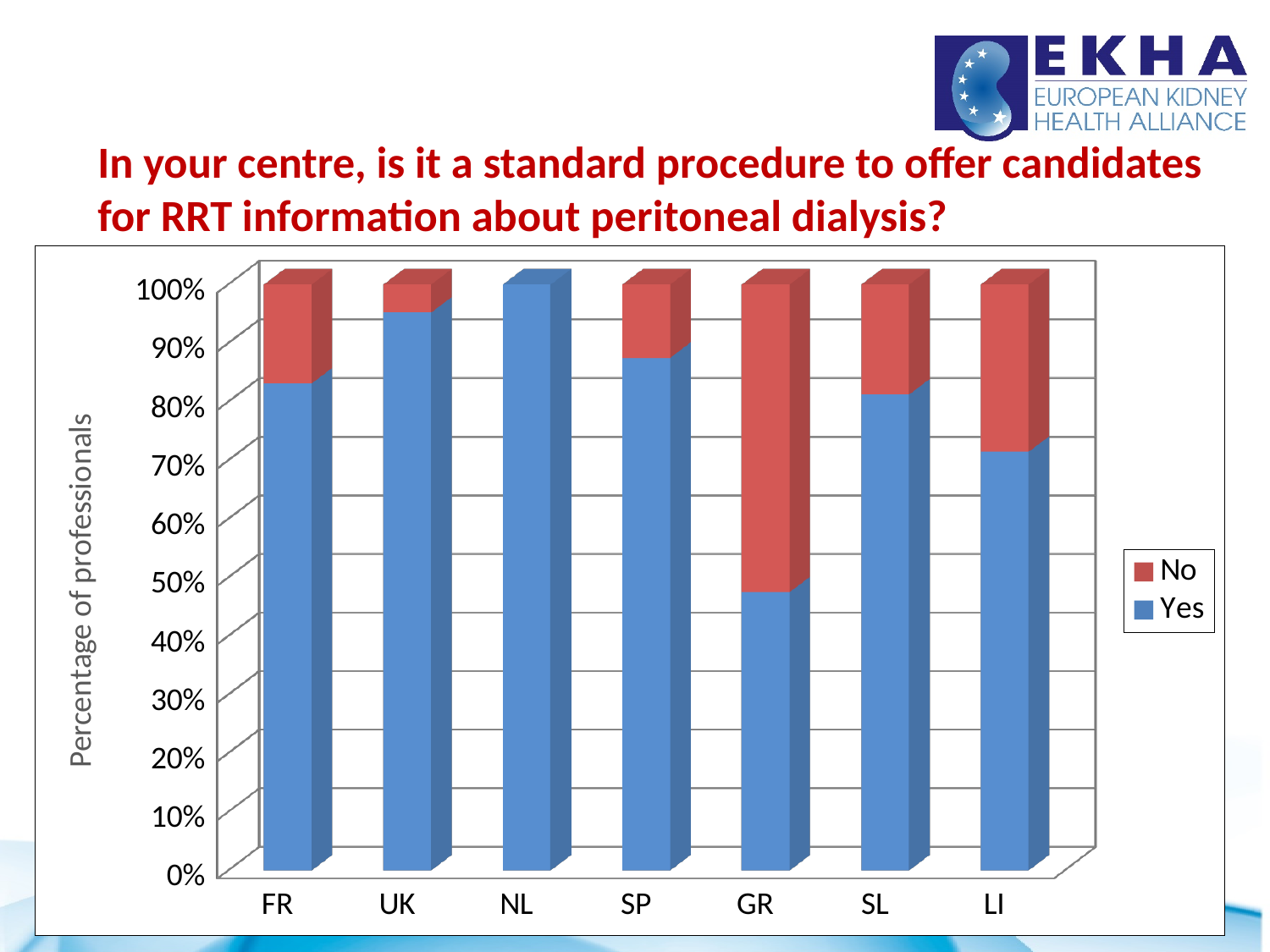
Is the Yes value for GR greater or less than 60%? less What is the label of the vertical axis? Percentage of professionals Is the Yes value for UK greater or less than 90%? greater Which has the larger Yes share, UK or FR? UK Which country has the lowest Yes share? GR What is the Yes value for NL? 100% Which country has the highest Yes share? NL Which country has the largest No share? GR How many countries are shown on the x axis of the chart? 7 How many series does the chart legend list? 2 Is the Yes value for LI greater or less than 80%? less What kind of chart is shown on the slide? Stacked bar chart